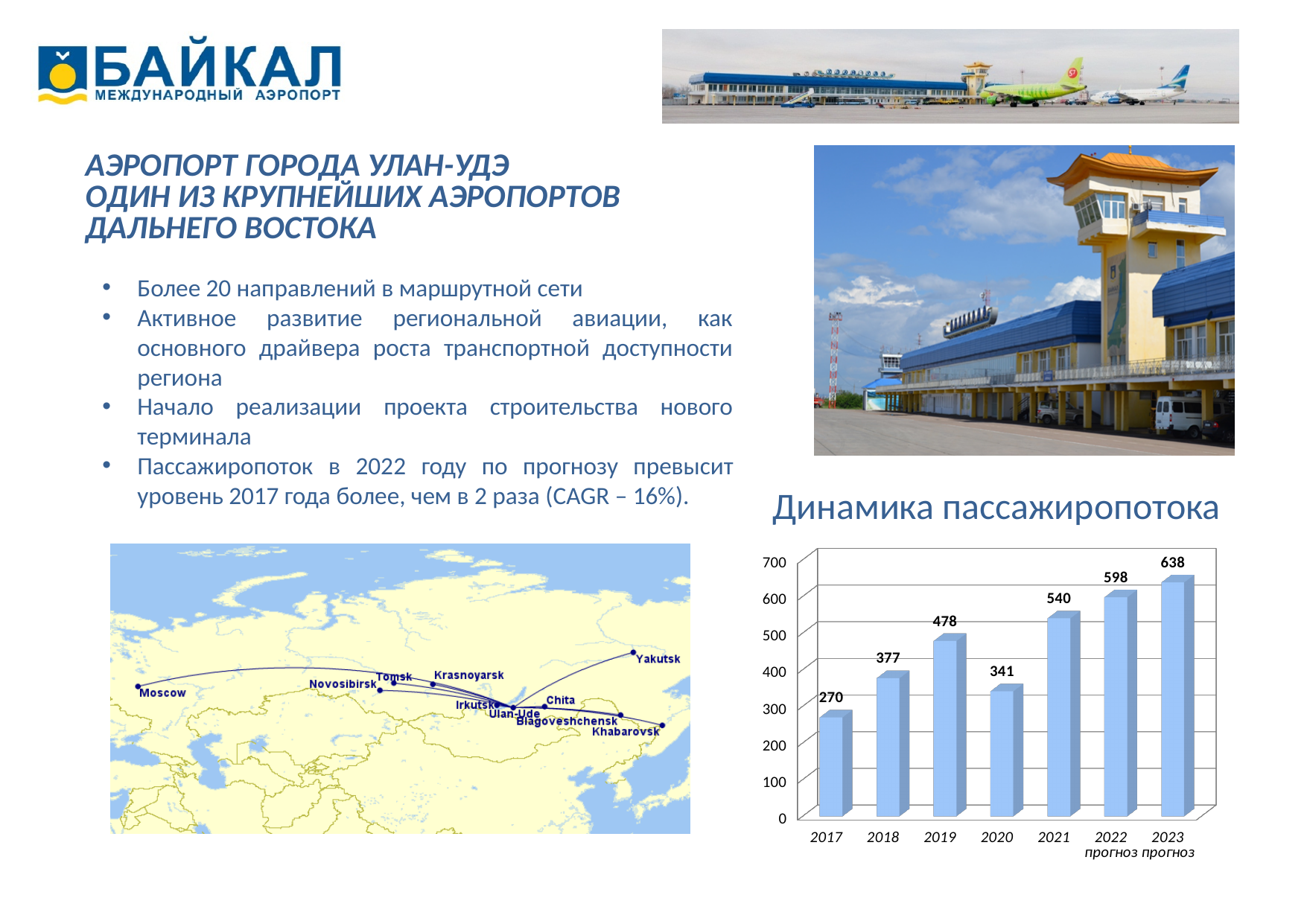
What is the title of the chart on the slide? Динамика пассажиропотока Is the value for 2021 in the 'Динамика пассажиропотока' chart greater or less than 500? greater What is the value for 2017 in the 'Динамика пассажиропотока' chart? 270 Which is larger in the 'Динамика пассажиропотока' chart, the value for 2018 or the value for 2020? 2018 Which year has the lowest value in the 'Динамика пассажиропотока' chart? 2017 What kind of chart is 'Динамика пассажиропотока'? bar chart What is the difference between the values for 2023 and 2017 in the 'Динамика пассажиропотока' chart? 368 Which year has the highest value in the 'Динамика пассажиропотока' chart? 2023 What is the difference between the values for 2019 and 2020 in the 'Динамика пассажиропотока' chart? 137 How many years are shown in the 'Динамика пассажиропотока' chart? 7 What is the value for 2020 in the 'Динамика пассажиропотока' chart? 341 What is the value for 2022 (прогноз) in the 'Динамика пассажиропотока' chart? 598